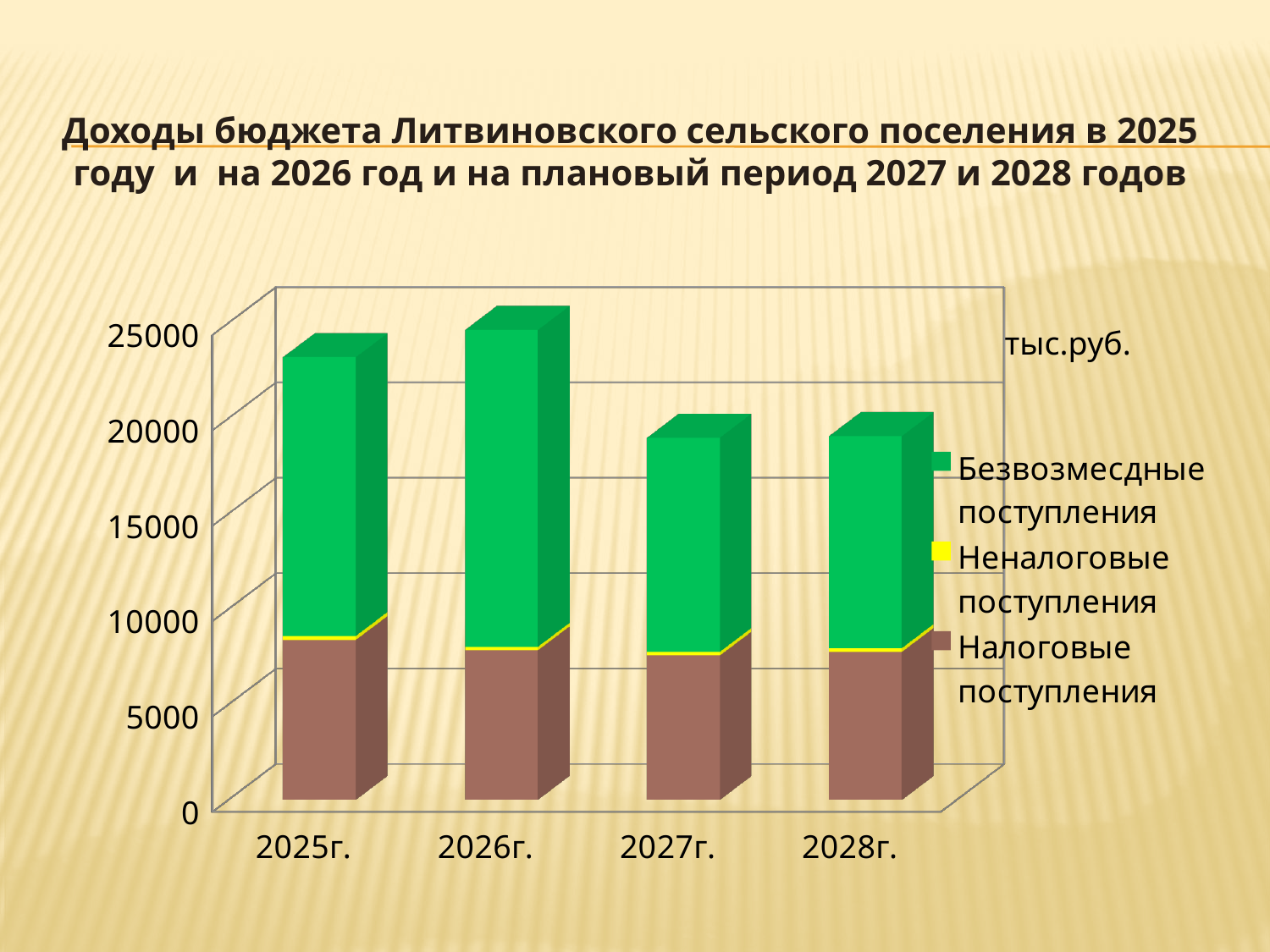
Is the value of Налоговые поступления for 2026г. greater or less than 5000? greater In what units are the values on the chart expressed? тыс.руб. Does the total budget income rise or fall from 2026г. to 2027г.? fall Which is larger, the total budget income for 2025г. or for 2026г.? 2026г. Which year has the highest total budget income in the chart? 2026г. Is the total budget income for 2025г. greater or less than 20000? greater Which is larger, the total budget income for 2025г. or for 2027г.? 2025г. Is the total budget income for 2027г. greater or less than 25000? less How many series does the chart legend list? 3 What kind of chart is shown on the slide? Stacked bar chart How many years (categories) are shown on the x axis of the chart? 4